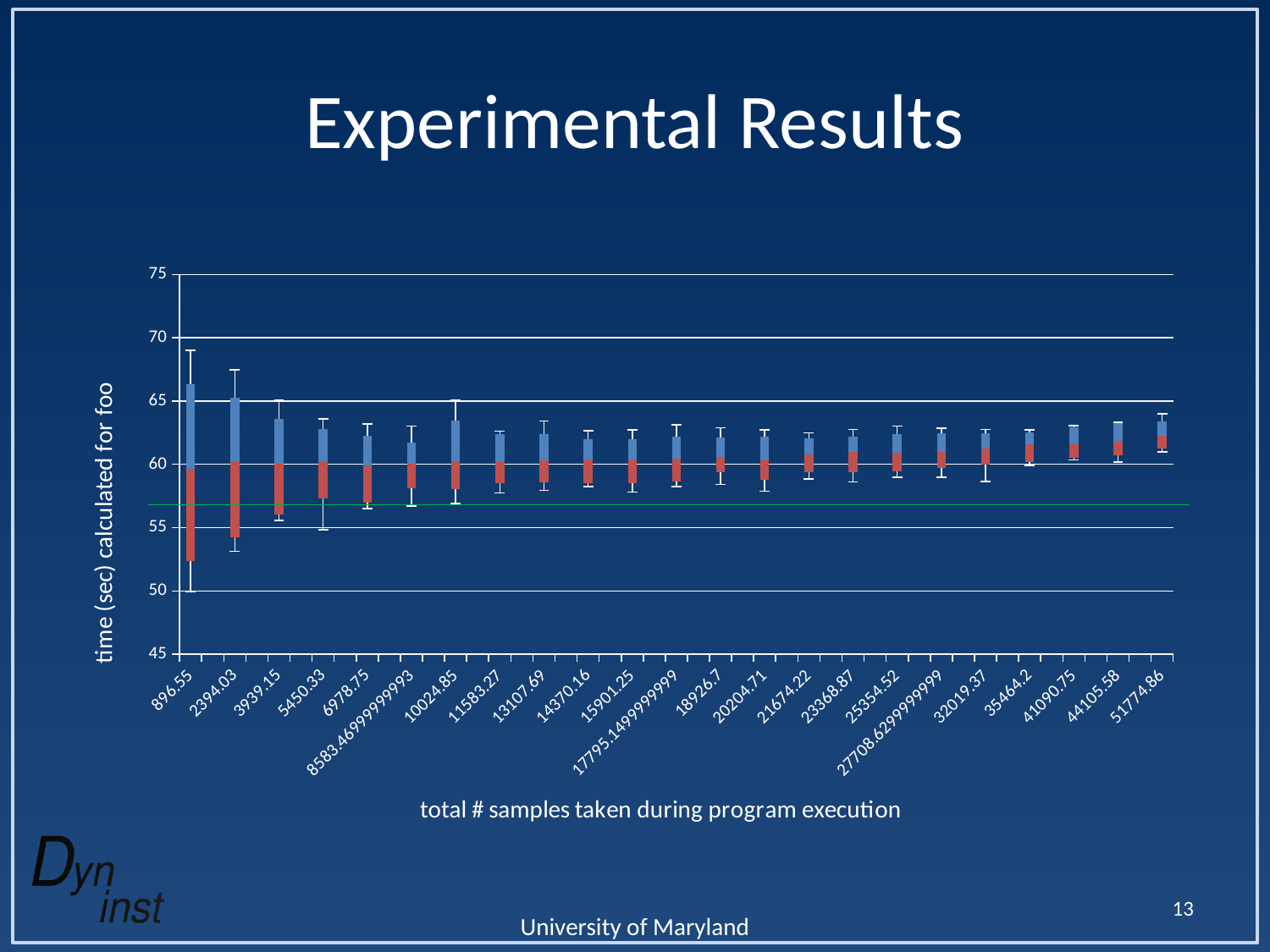
What is the lowest value shown on the y axis? 45 Is the top of the blue bar for 896.55 greater or less than 65? greater What is the label of the x axis? total # samples taken during program execution Does the spread of the plotted ranges widen or narrow as the number of samples increases along the x axis? narrow Is the bottom of the red bar for 51774.86 greater or less than 60? greater Is the bottom of the red bar for 896.55 greater or less than 55? less How many categories are plotted along the x axis? 23 What kind of chart is shown on the slide? box-and-whisker (floating bar) chart Which category has the widest spread between its upper and lower whiskers? 896.55 What is the label of the y axis? time (sec) calculated for foo